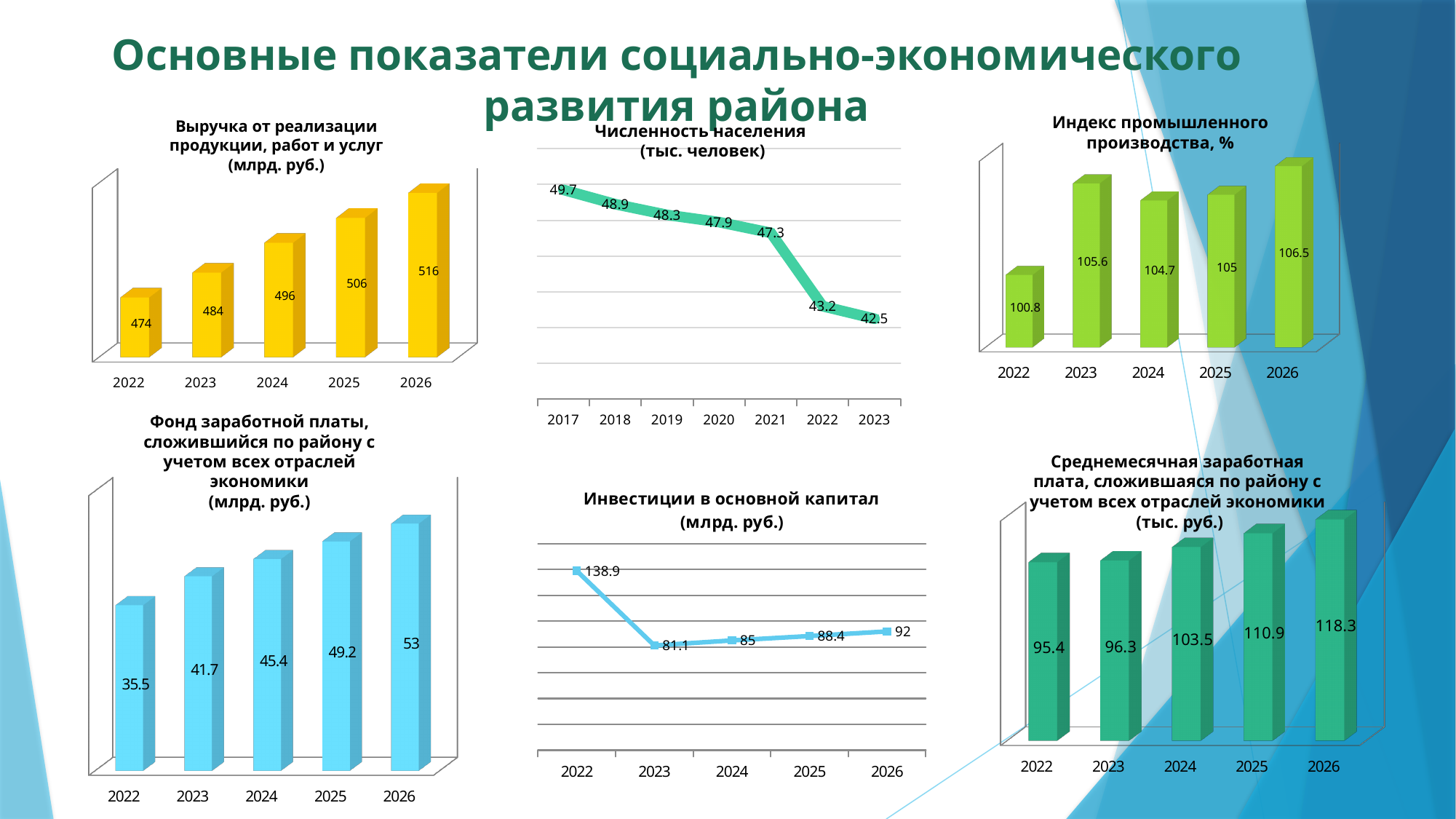
In the chart 'Индекс промышленного производства, %', which is larger: the value for 2023 or the value for 2024? 2023 What kind of chart is 'Инвестиции в основной капитал (млрд. руб.)'? line chart How many years are shown in the chart 'Фонд заработной платы, сложившийся по району с учетом всех отраслей экономики (млрд. руб.)'? 5 In the chart 'Численность населения (тыс. человек)', do the values rise or fall from 2017 to 2023? fall In the chart 'Инвестиции в основной капитал (млрд. руб.)', what is the value for 2022? 138.9 In the chart 'Выручка от реализации продукции, работ и услуг (млрд. руб.)', what is the value for 2024? 496 In the chart 'Фонд заработной платы, сложившийся по району с учетом всех отраслей экономики (млрд. руб.)', what is the value for 2025? 49.2 In the chart 'Численность населения (тыс. человек)', what is the value for 2021? 47.3 In the chart 'Среднемесячная заработная плата, сложившаяся по району с учетом всех отраслей экономики (тыс. руб.)', what is the difference between the 2026 and 2025 values? 7.4 In the chart 'Численность населения (тыс. человек)', which year has the lowest value? 2023 In the chart 'Выручка от реализации продукции, работ и услуг (млрд. руб.)', what is the difference between the 2026 and 2022 values? 42 In the chart 'Индекс промышленного производства, %', which year has the highest value? 2026